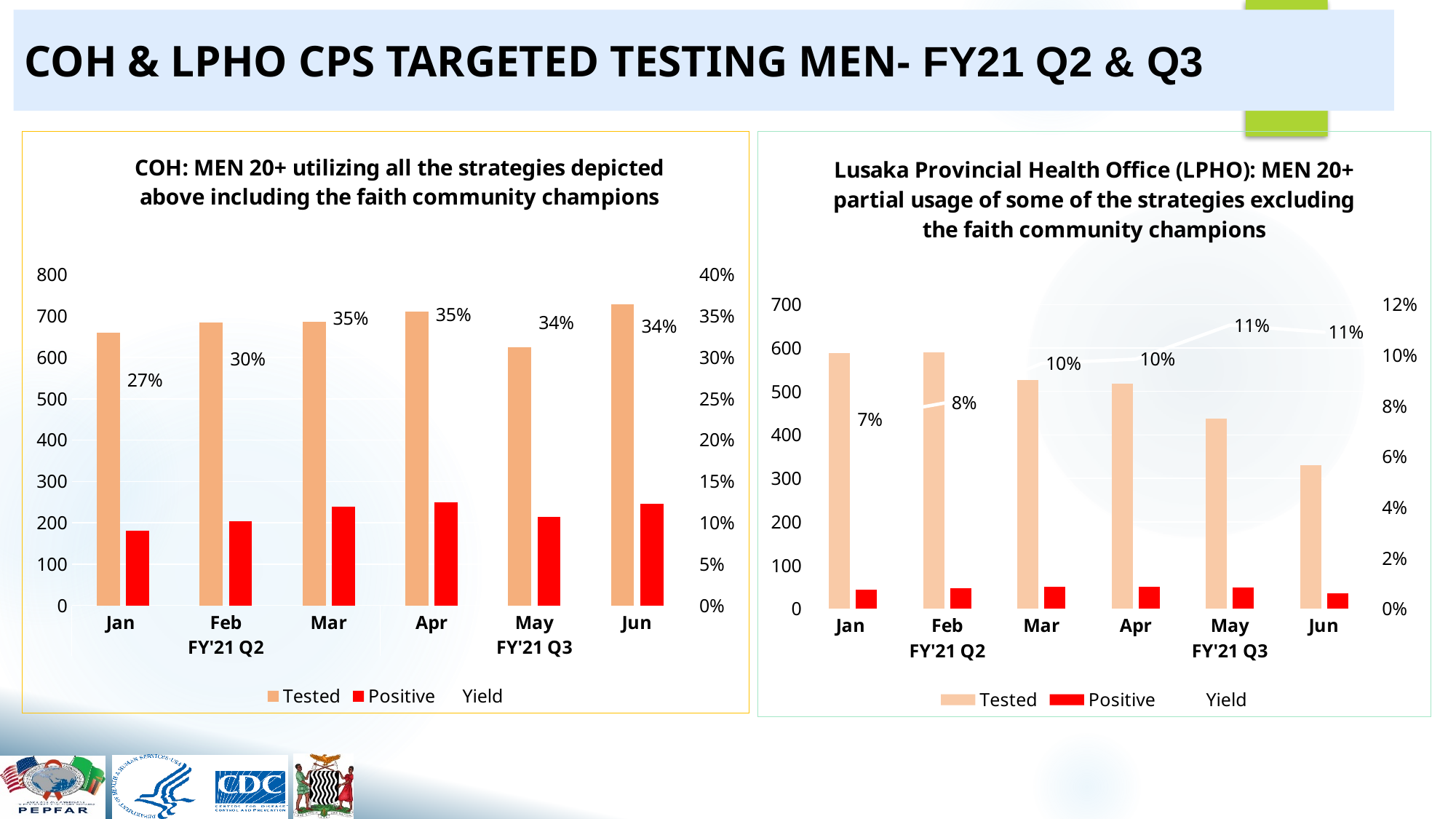
In the LPHO chart on the right, what is the yield for Jun? 11% In the COH chart on the left, which month has the lowest yield? Jan In the LPHO chart on the right, does the yield generally rise or fall from Jan to Jun? rise In the COH chart on the left, is the Tested value for Jan greater or less than 600? greater In the LPHO chart on the right, which month has the lowest yield? Jan In the LPHO chart on the right, by how many percentage points does the Jun yield exceed the Jan yield? 4 percentage points How many series does the legend of the COH chart on the left list? 3 In the COH chart on the left, what is the yield for Feb? 30% In the LPHO chart on the right, is the Tested value for Jun greater or less than 400? less In the COH chart on the left, by how many percentage points does the Jun yield exceed the Jan yield? 7 percentage points In the LPHO chart on the right, what is the yield for Mar? 10% In the COH chart on the left, what is the yield for Jan? 27%